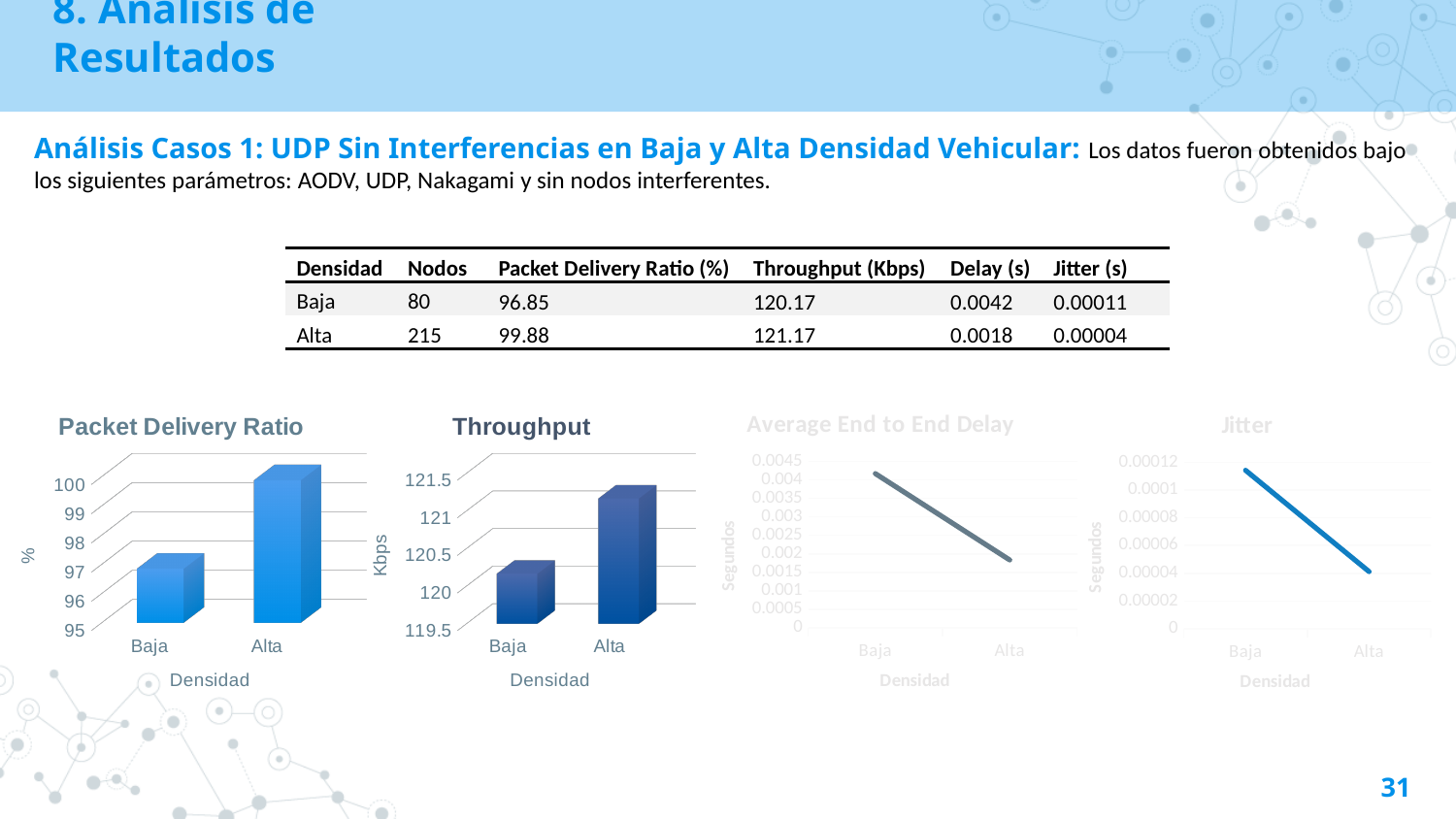
In the Packet Delivery Ratio chart, is the value for Baja greater or less than 98? less In the Throughput chart, which density has the higher value, Baja or Alta? Alta In the Average End to End Delay chart, does the value rise or fall from Baja to Alta? fall In the Packet Delivery Ratio chart, is the value for Alta greater or less than 99? greater In the Jitter chart, is the value for Baja greater or less than 0.00008? greater What kind of chart is the Packet Delivery Ratio chart? bar chart What kind of chart is the Jitter chart? line chart How many density categories are shown on the x axis of the Packet Delivery Ratio chart? 2 What is the y-axis label of the Throughput chart? Kbps